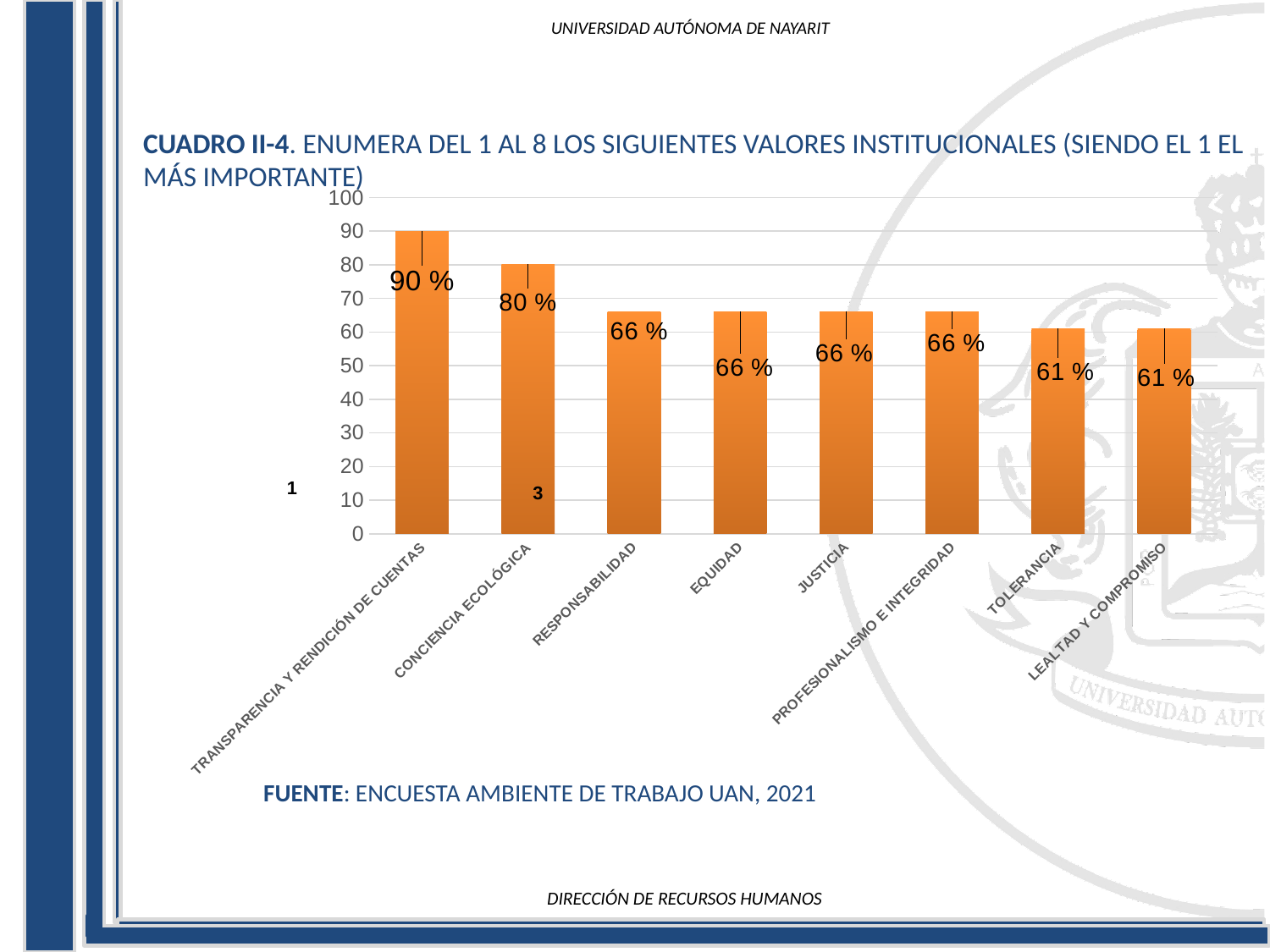
What is the source cited below the chart? ENCUESTA AMBIENTE DE TRABAJO UAN, 2021 What is the difference between the values for RESPONSABILIDAD and LEALTAD Y COMPROMISO? 5 % How many categories are shown on the x axis? 8 What is the value for EQUIDAD? 66 % What is the difference between the values for TRANSPARENCIA Y RENDICIÓN DE CUENTAS and CONCIENCIA ECOLÓGICA? 10 % What is the value for CONCIENCIA ECOLÓGICA? 80 % Which category has the highest value? TRANSPARENCIA Y RENDICIÓN DE CUENTAS What is the value for TOLERANCIA? 61 % Which is larger, the value for CONCIENCIA ECOLÓGICA or the value for JUSTICIA? CONCIENCIA ECOLÓGICA What kind of chart is shown on the slide? bar chart Is the value for PROFESIONALISMO E INTEGRIDAD greater or less than 70? less What is the value for TRANSPARENCIA Y RENDICIÓN DE CUENTAS? 90 %